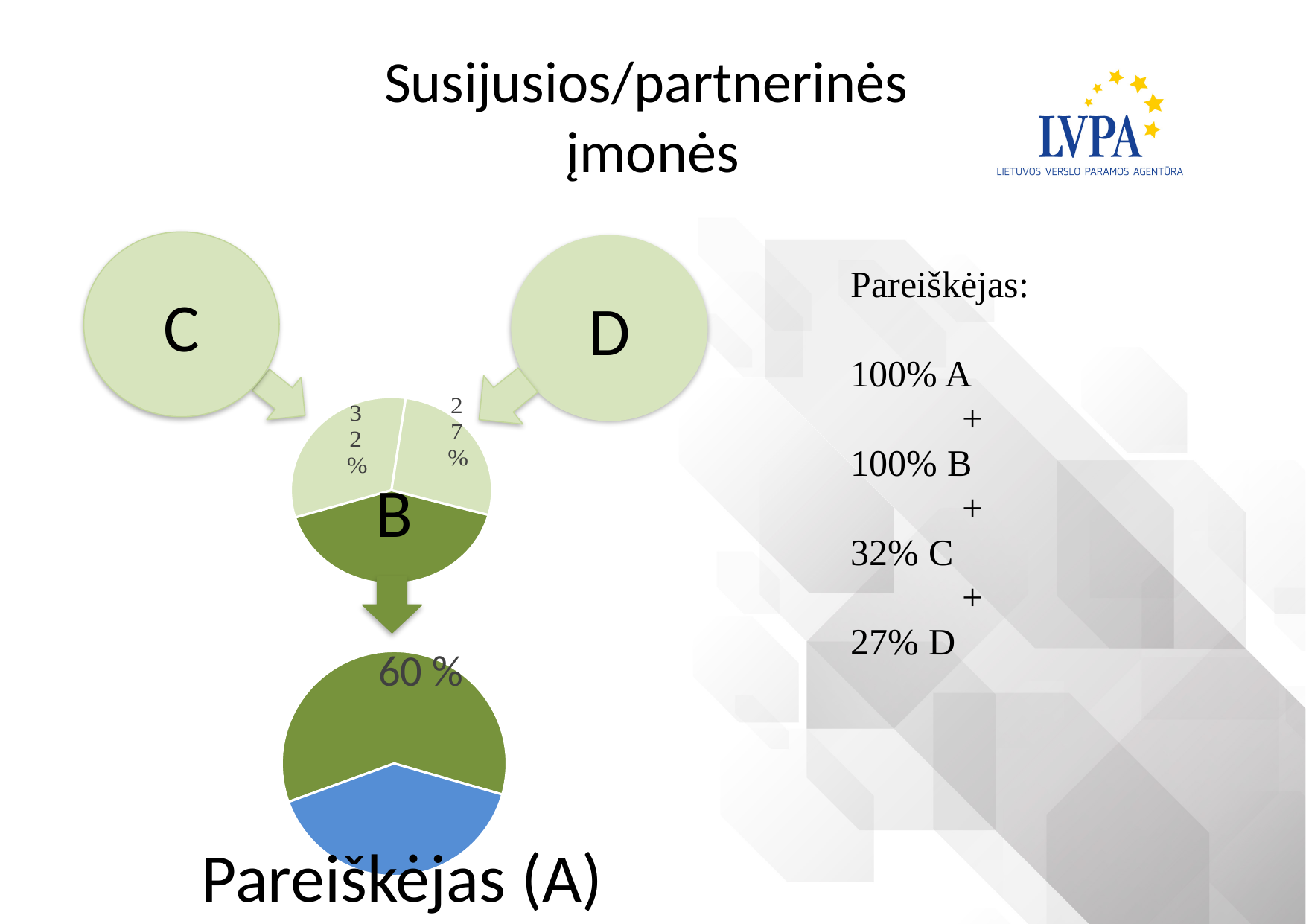
In the pie chart labelled B, what value is printed on the slice the arrow from C points to? 32% What is the title of the slide containing the two pie charts? Susijusios/partnerinės įmonės In the pie chart labelled B, which of the two labelled slices is larger, the 32% slice or the 27% slice? the 32% slice What kind of chart is the chart labelled B in the middle of the slide? pie chart In the pie chart labelled B, which slice is the smallest? the 27% slice In the pie chart labelled B, what value is printed on the slice the arrow from D points to? 27% In the pie chart labelled B, what is the difference between the two labelled slices, 32% and 27%? 5% In the pie chart labelled Pareiškėjas (A), what share is printed on the green slice? 60 % In the pie chart labelled Pareiškėjas (A), how many slices are there? 2 What kind of chart is the chart labelled Pareiškėjas (A) at the bottom of the slide? pie chart In the pie chart labelled B, how many slices are there? 3 In the pie chart labelled Pareiškėjas (A), which slice is larger, the green one or the blue one? the green one